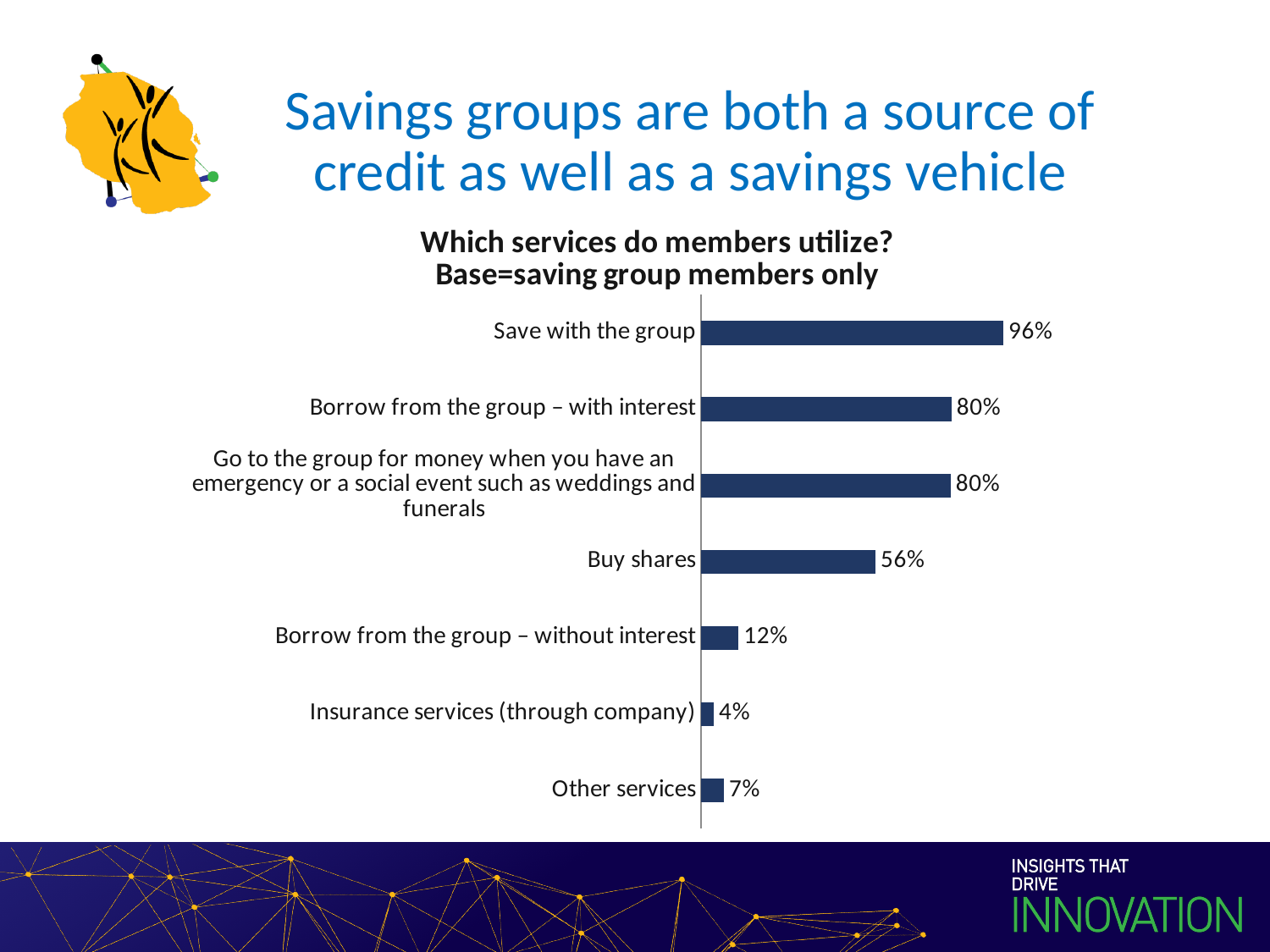
How many services are listed in the chart? 7 What percentage of members borrow from the group without interest? 12% What percentage of members use insurance services (through company)? 4% What is the difference between borrowing from the group with interest and borrowing without interest? 68% Which is larger: the percentage for Other services or for Insurance services (through company)? Other services What percentage of members buy shares? 56% What type of chart is shown on the slide? Bar chart What percentage of members save with the group? 96% Which service has the highest share of members utilizing it? Save with the group What is the difference between the percentage who save with the group and the percentage who buy shares? 40% Which service has the lowest share of members utilizing it? Insurance services (through company) What is the title of the chart? Which services do members utilize? Base=saving group members only